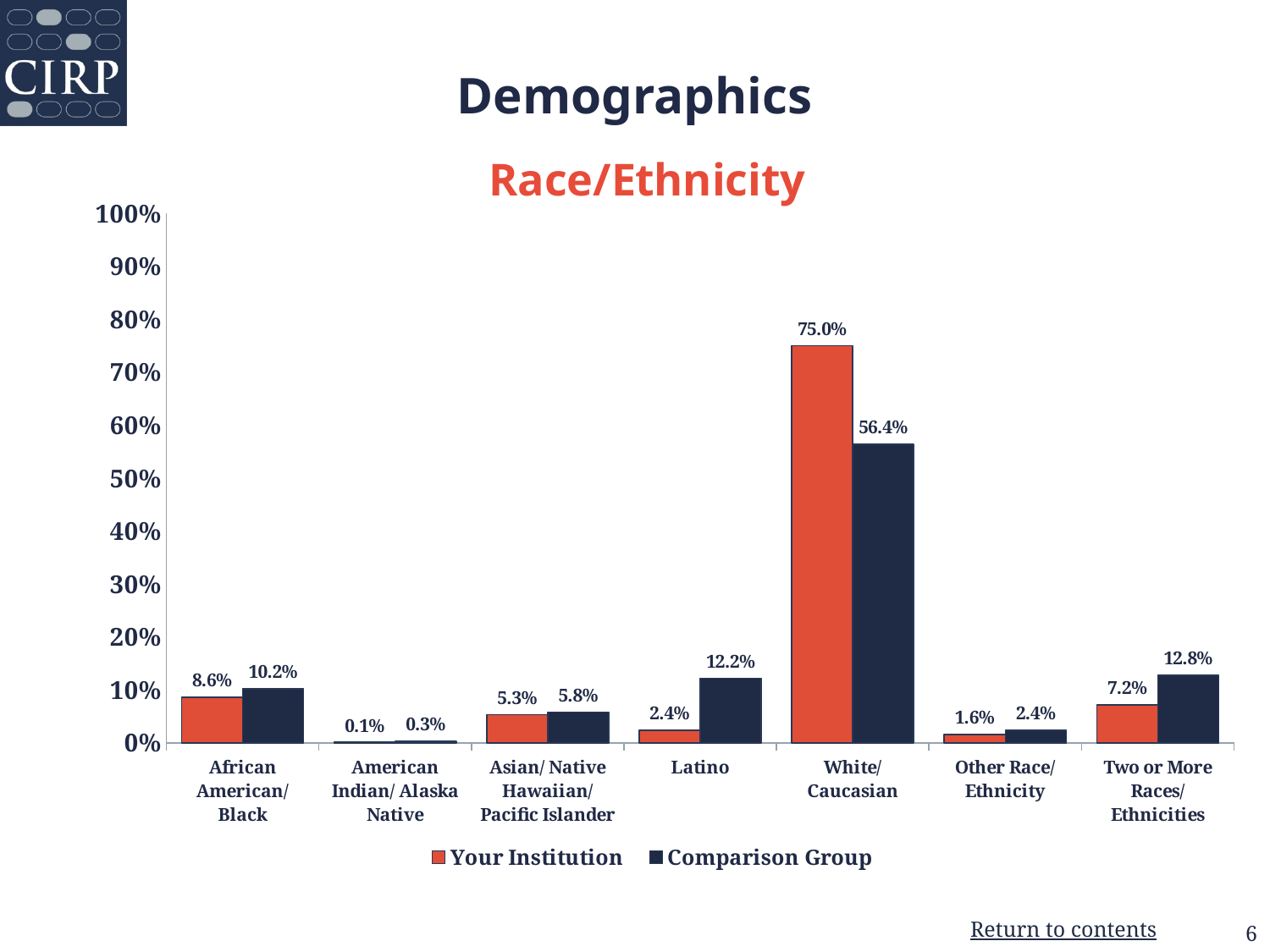
What is the Your Institution value for Two or More Races/Ethnicities? 7.2% For African American/Black, which is larger: Your Institution or Comparison Group? Comparison Group What is the difference between the Comparison Group and Your Institution values for Latino? 9.8% How many race/ethnicity categories are shown on the x axis? 7 What is the Comparison Group value for Latino? 12.2% What is the Your Institution value for White/Caucasian? 75.0% Is the Comparison Group value for White/Caucasian greater or less than 60%? less Which race/ethnicity category has the highest Comparison Group value? White/Caucasian How many series does the legend list? 2 What is the difference between the Your Institution and Comparison Group values for White/Caucasian? 18.6% What kind of chart is shown on the slide? Bar chart Which race/ethnicity category has the lowest Your Institution value? American Indian/Alaska Native